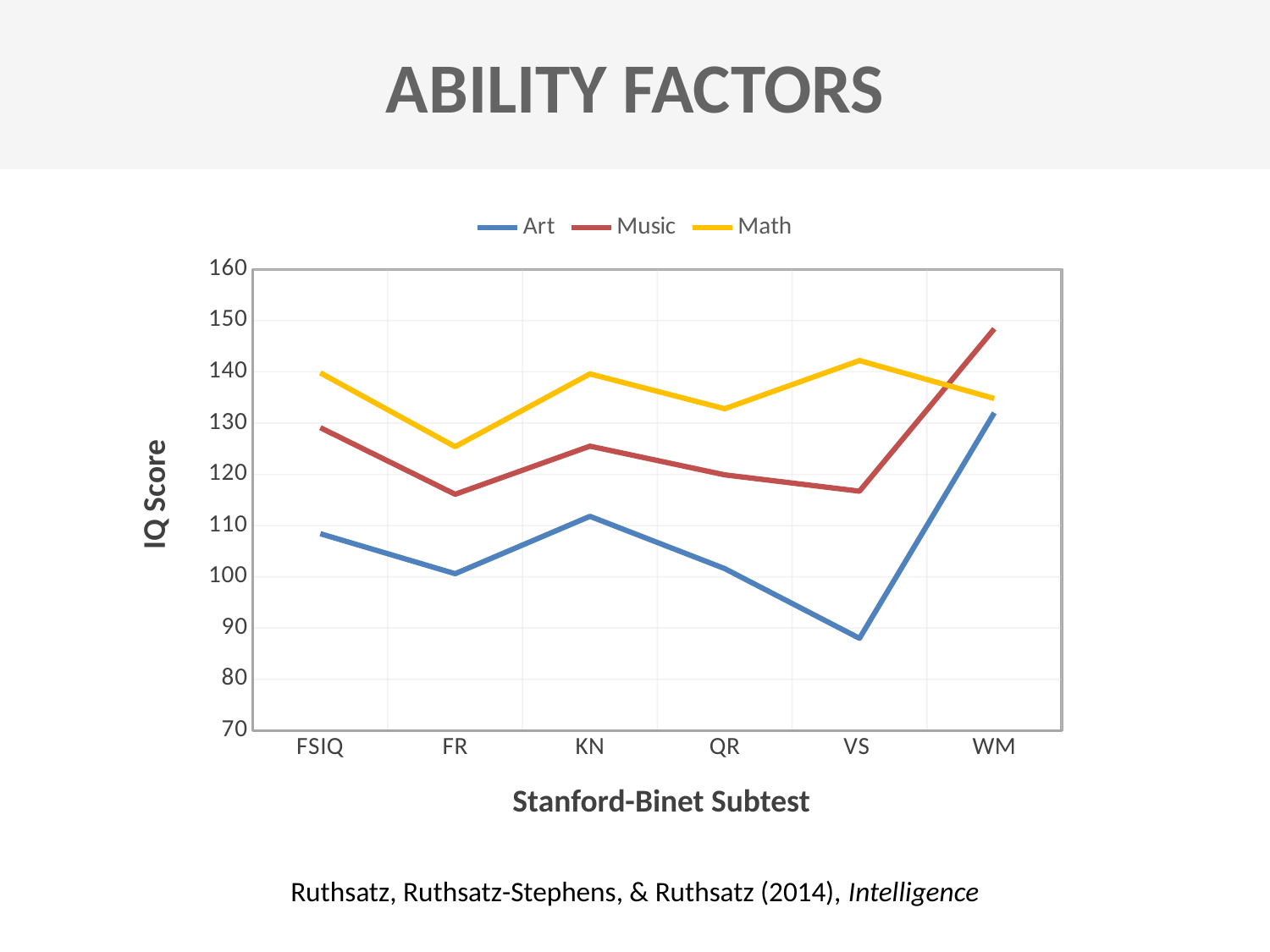
Is the Math value for FR greater or less than 130? less How many subtests are shown along the x axis? 6 How many series does the legend list? 3 At WM, which series has the higher value, Music or Math? Music What is the label on the y axis? IQ Score For which subtest is the Math series lowest? FR For which subtest is the Art series lowest? VS Is the Music value for FR greater or less than 120? less What kind of chart is shown on the slide? line chart For which subtest is the Art series highest? WM Is the Art value for VS greater or less than 100? less